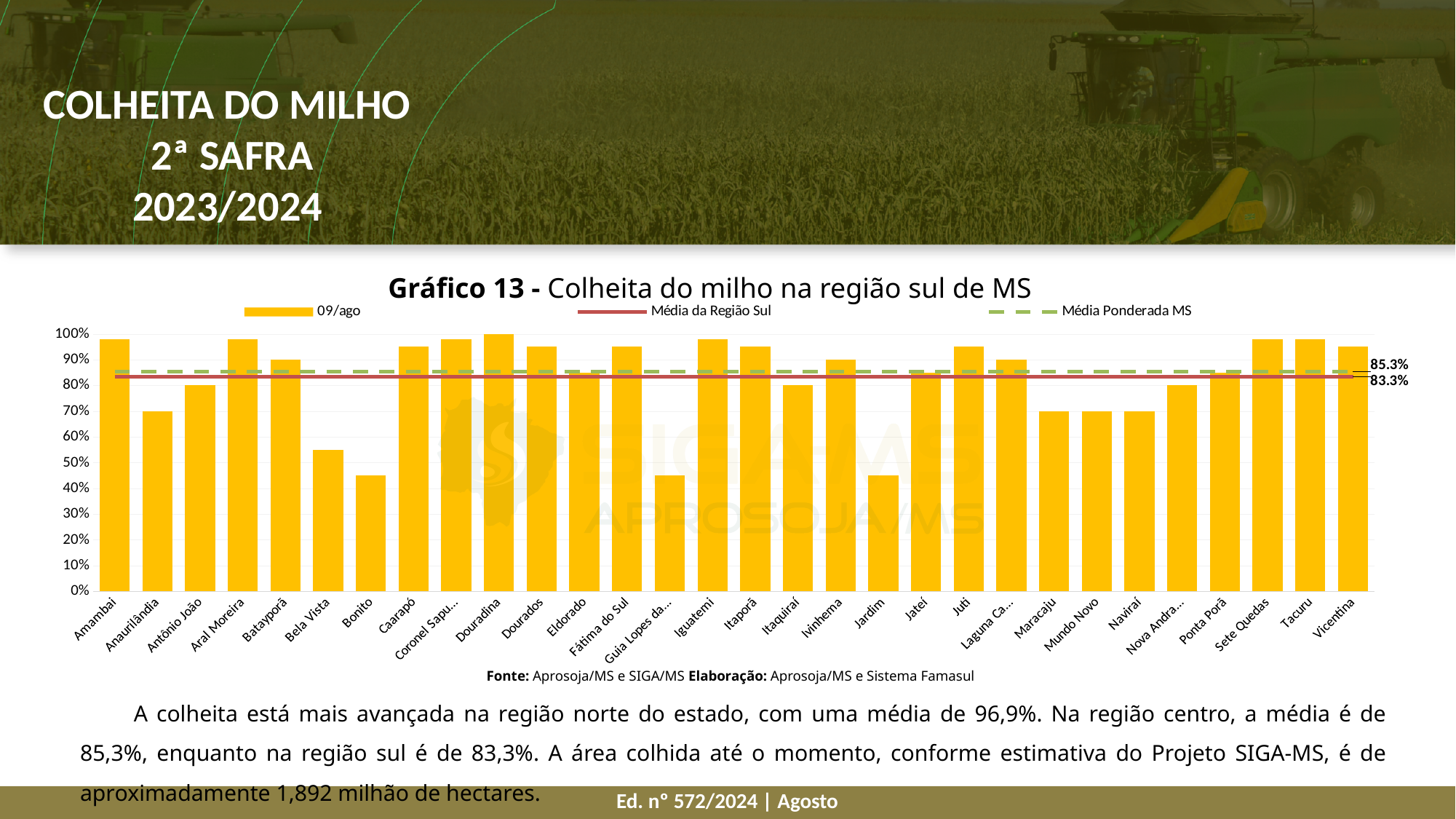
How many municipalities are shown on the x axis of Gráfico 13? 30 Which has a higher value, Amambai or Anaurilândia? Amambai What date does the legend give for the bar series in Gráfico 13? 09/ago Which municipality has the highest harvest percentage in Gráfico 13? Douradina What value is labelled for the Média Ponderada MS line? 85.3% Is the value for Caarapó greater or less than 90%? greater Is the value for Bela Vista greater or less than 60%? less What value is labelled for the Média da Região Sul line? 83.3% What kind of chart is Gráfico 13? combination bar and line chart What is the difference between the Média Ponderada MS (85.3%) and the Média da Região Sul (83.3%)? 2.0% How many series does the legend of Gráfico 13 list? 3 Is the value for Jardim greater or less than 50%? less